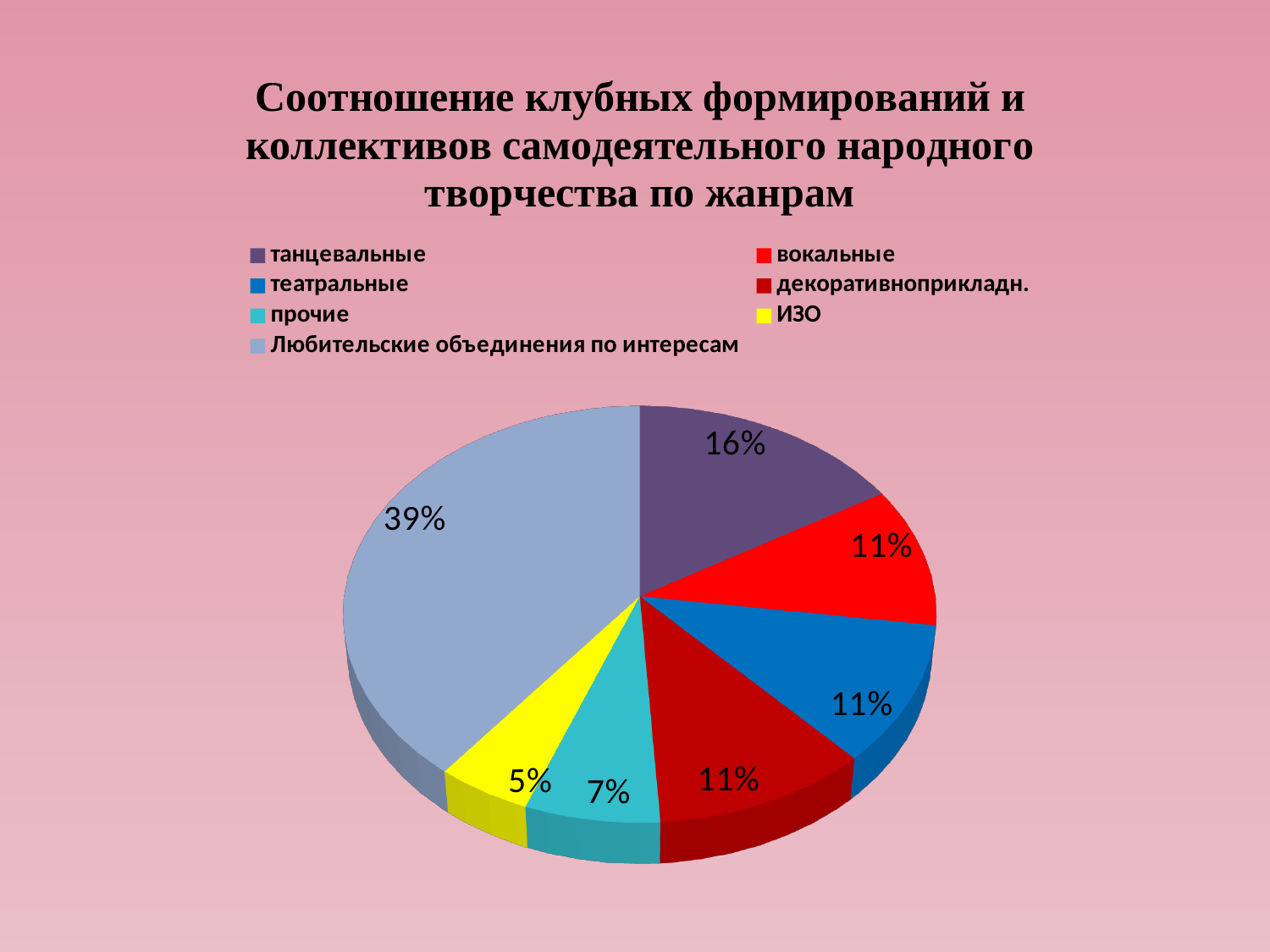
How many slices does the pie chart have? 7 Which category has the largest slice of the pie? Любительские объединения по интересам Which category has the smallest slice of the pie? ИЗО Which is larger, the slice for танцевальные or the slice for прочие? танцевальные What percentage is shown for ИЗО? 5% What percentage is shown for прочие? 7% What share of the pie is labelled for Любительские объединения по интересам? 39% What is the difference in percentage points between Любительские объединения по интересам and танцевальные? 23 What percentage is shown for танцевальные? 16% What type of chart is shown on the slide? pie chart What colour is the slice for ИЗО? yellow What percentage is shown for вокальные? 11%